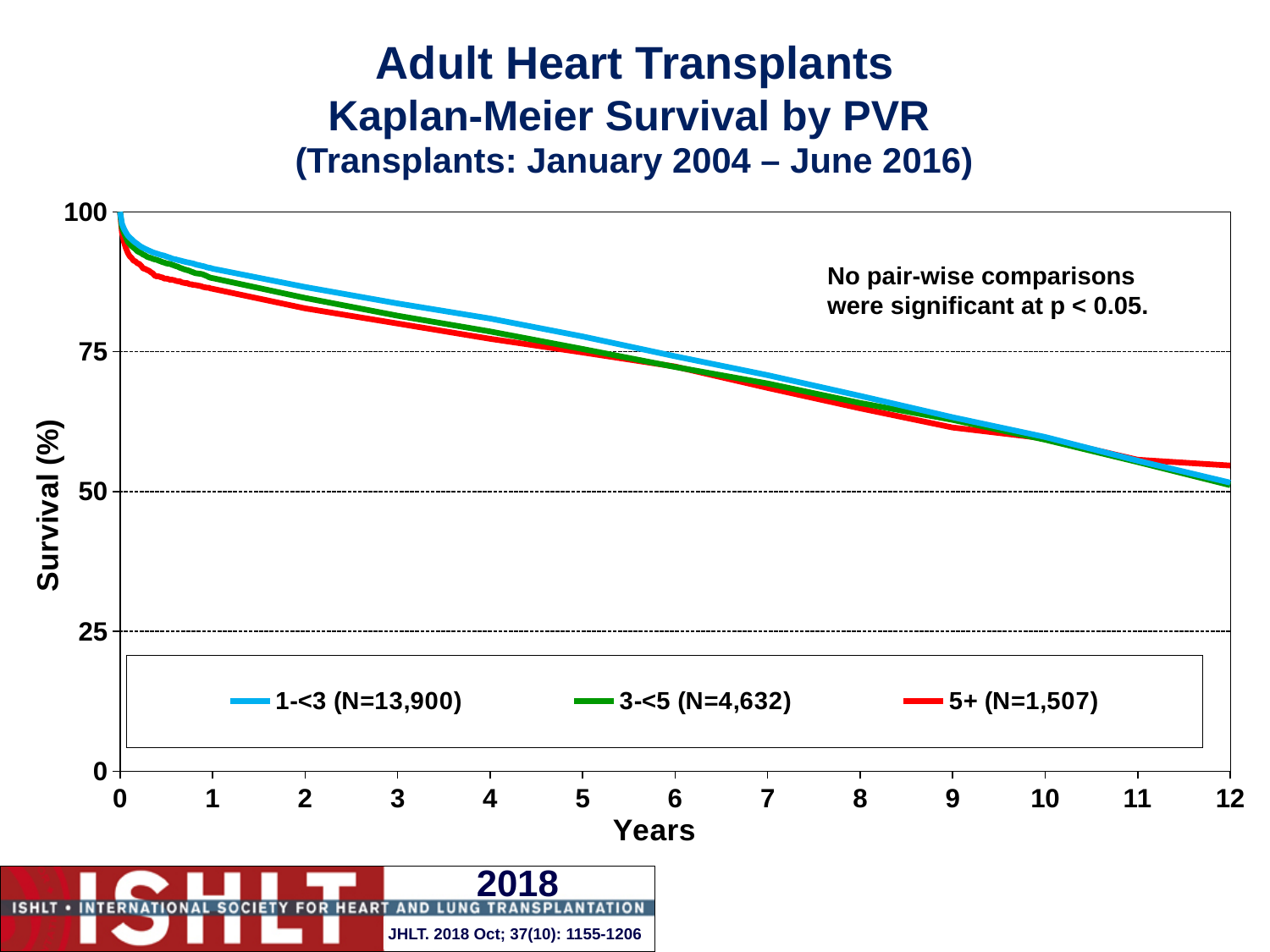
Is the survival value for the 5+ group at year 1 greater or less than 75? greater Is the survival value for the 3-<5 group at year 9 greater or less than 50? greater At year 1, which group has higher survival: 1-<3 or 5+? 1-<3 Is the survival value for the 1-<3 group at year 6 greater or less than 50? greater How many series does the legend list? 3 Do the survival curves rise or fall as years increase? Fall Which PVR group has the smallest N in the legend? 5+ (N=1,507) According to the legend, what is the N for the 1-<3 PVR group? 13,900 What kind of chart is shown on the slide? Line chart At year 12, which group has higher survival: 5+ or 1-<3? 5+